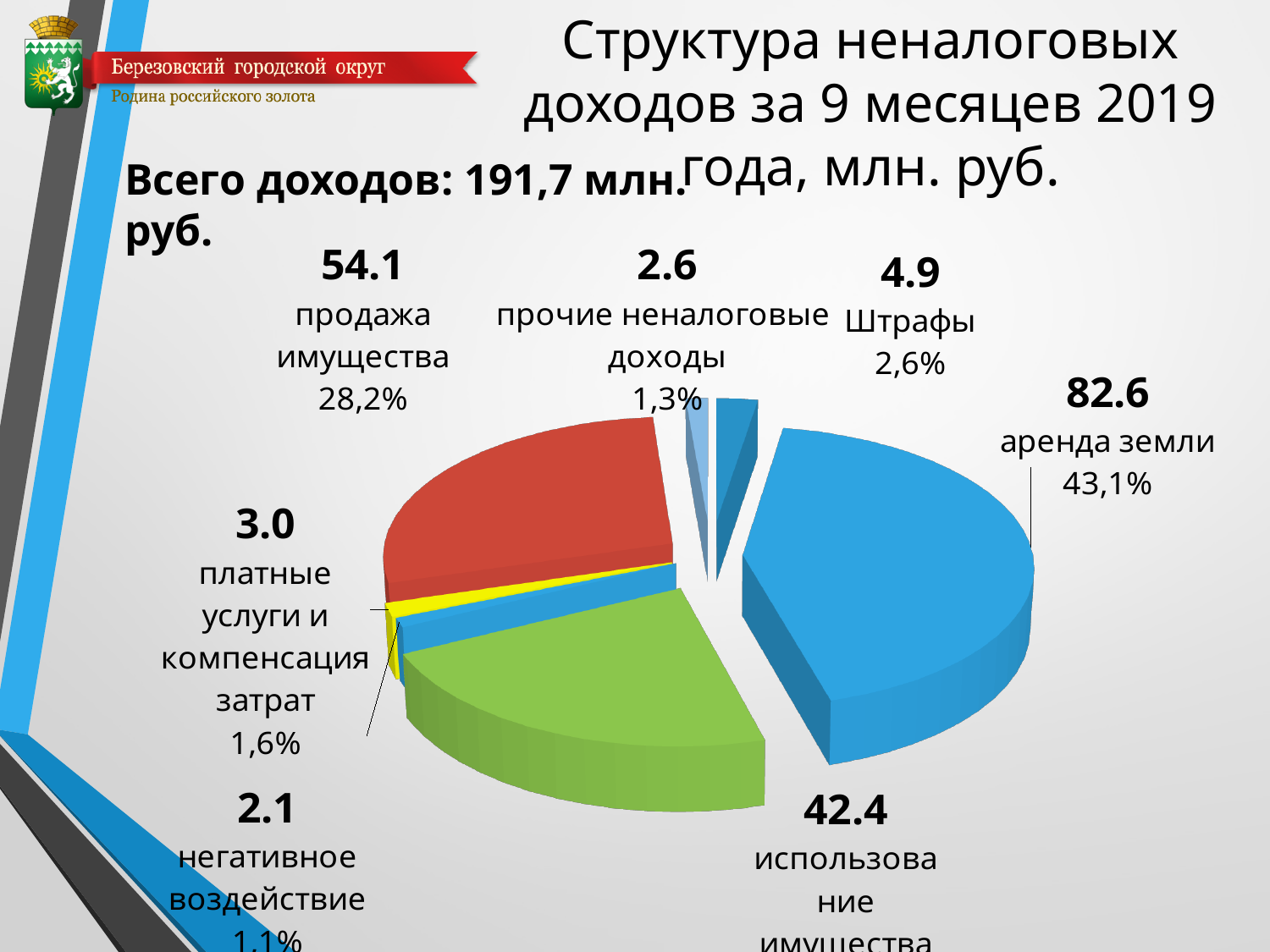
What kind of chart is shown on the slide? pie chart What is the value for прочие неналоговые доходы? 2.6 Which category has the largest slice of the pie? аренда земли What is the difference between the values for аренда земли and продажа имущества? 28.5 What is the value for аренда земли? 82.6 How many categories are shown in the pie chart? 7 What is the value for негативное воздействие? 2.1 What share of the pie does аренда земли represent? 43,1% What share of the pie does продажа имущества represent? 28,2% What is the value for Штрафы? 4.9 What is the value for продажа имущества? 54.1 Which category has the smallest slice of the pie? негативное воздействие